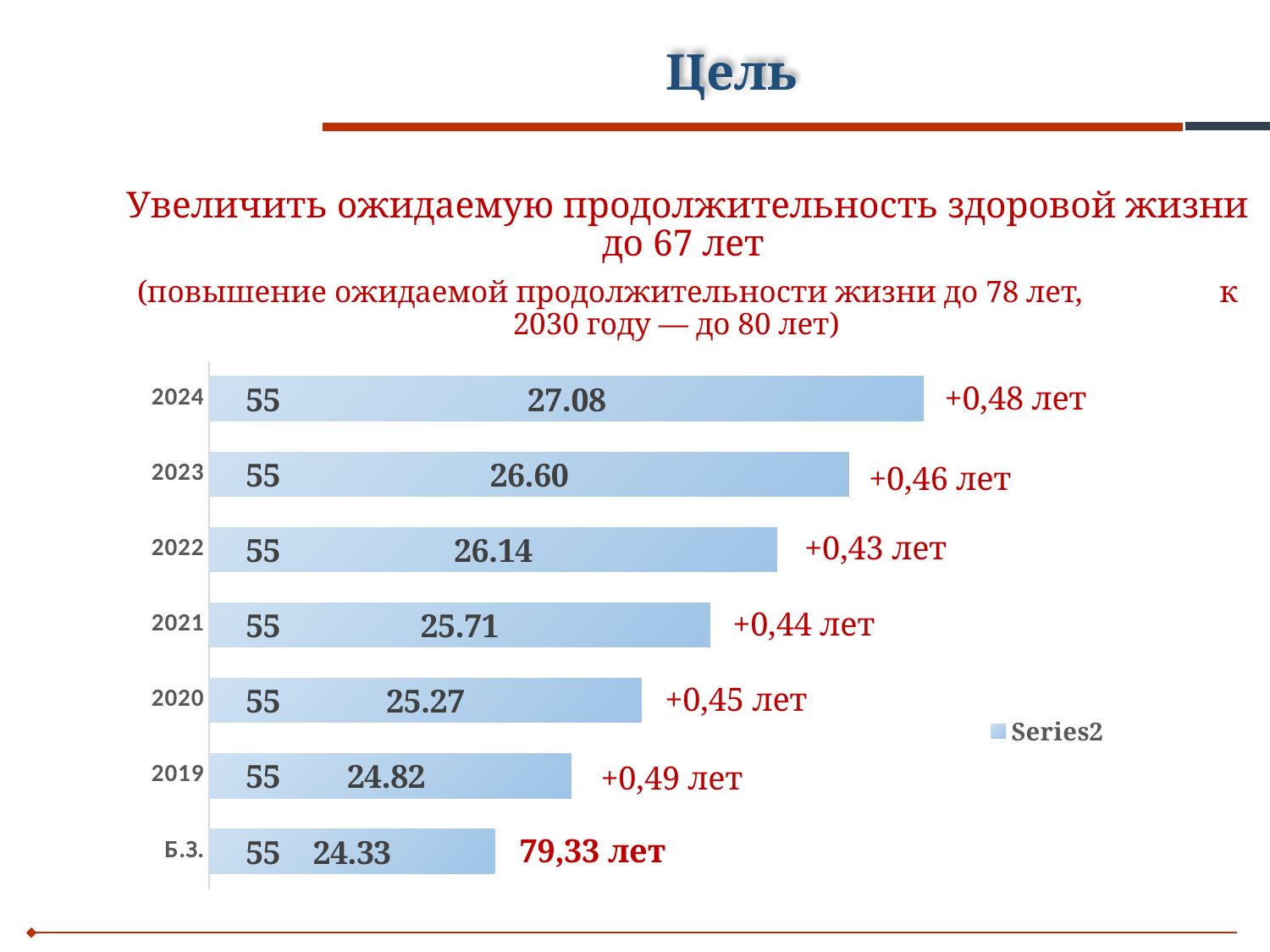
What is the name of the series listed in the legend? Series2 Which is larger, the second-segment value for 2022 or for 2020? 2022 Which category has the smallest second-segment value? Б.З. How many series does the legend list? 1 How many categories are shown on the chart? 7 What is the difference between the second-segment values for 2024 and Б.З.? 2.75 Which category has the largest second-segment value? 2024 What is the value of the second (right) segment of the bar for 2024? 27.08 What is the value of the second (right) segment of the bar for 2021? 25.71 What is the value of the first (left) segment of the bar for 2019? 55 What kind of chart is shown on the slide? bar chart What is the total of the stacked bar for 2024? 82.08